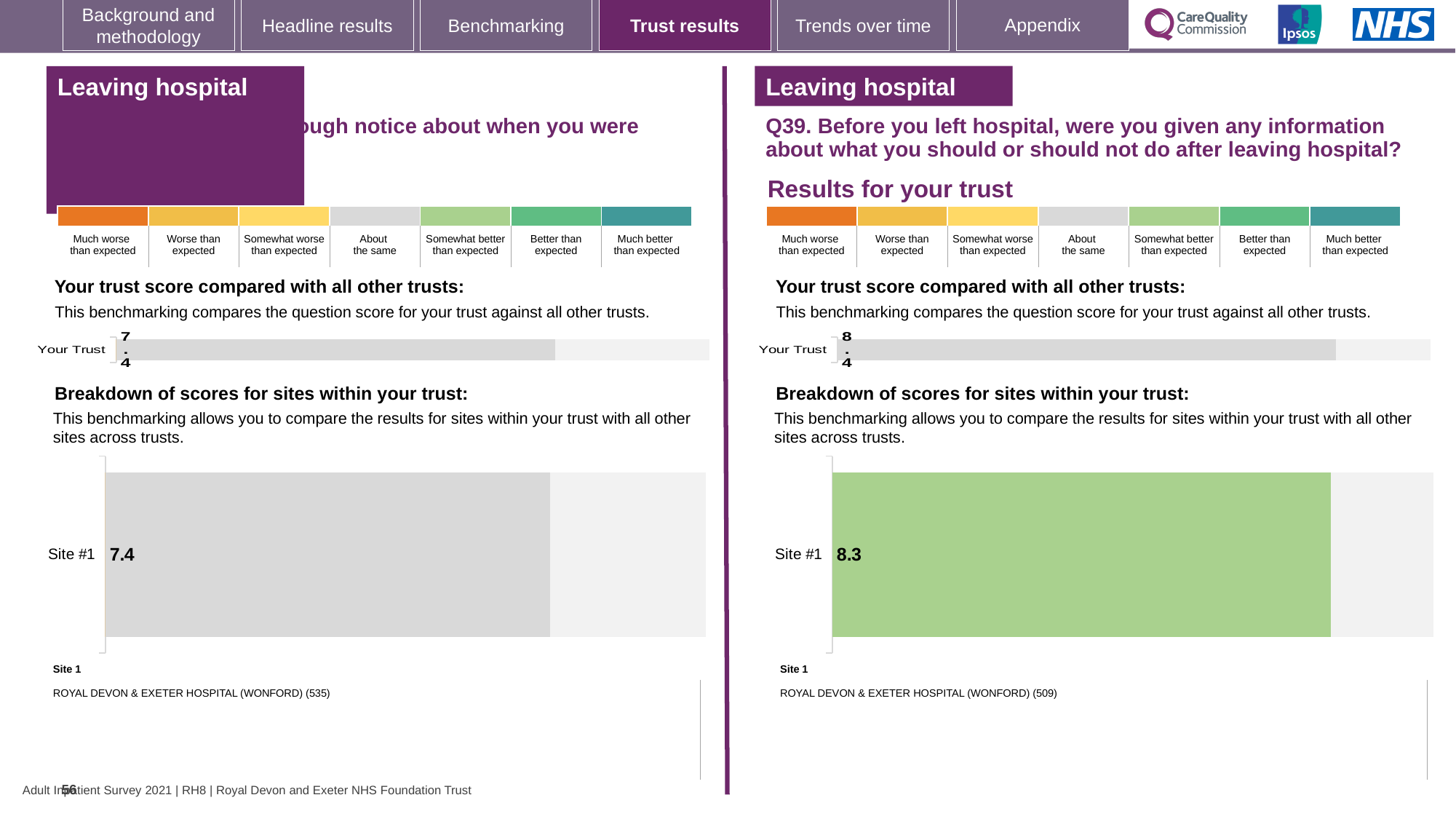
What is the difference between the Your Trust score on the right-hand panel (Q39) and the Your Trust score on the left-hand panel? 1.0 On the left-hand panel, what is the score shown for Your Trust in the 'Your trust score compared with all other trusts' chart? 7.4 Which panel shows the higher Site #1 score, the left-hand panel or the right-hand panel (Q39)? Right-hand panel (Q39) On the right-hand panel (Q39), what colour is the Site #1 bar in the breakdown chart? Green On the right-hand panel (Q39), what is the score shown for Your Trust in the 'Your trust score compared with all other trusts' chart? 8.4 On the left-hand panel, what colour is the Site #1 bar in the breakdown chart? Grey What is the difference between the Site #1 score on the right-hand panel (Q39) and the Site #1 score on the left-hand panel? 0.9 How many sites are shown in the 'Breakdown of scores for sites within your trust' chart on the right-hand panel (Q39)? 1 On the left-hand panel, what score is shown for Site #1 in the 'Breakdown of scores for sites within your trust' chart? 7.4 On the right-hand panel (Q39), what score is shown for Site #1 in the 'Breakdown of scores for sites within your trust' chart? 8.3 On the right-hand panel (Q39), which is higher: the Your Trust score or the Site #1 score? Your Trust score What type of chart is used to show the Site #1 score in the 'Breakdown of scores for sites within your trust' section? Bar chart